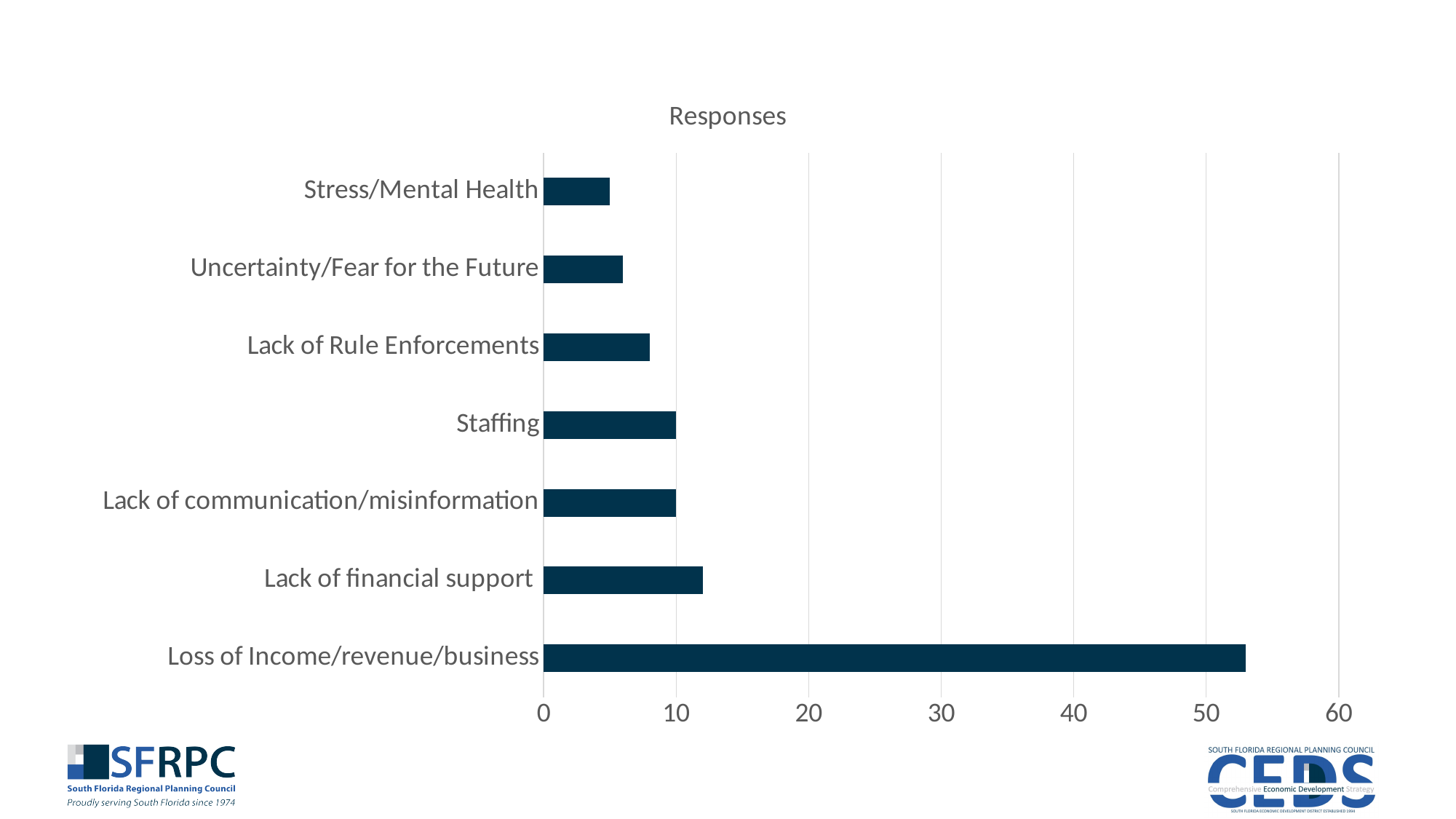
Which category has the highest number of responses? Loss of Income/revenue/business Is the value for Stress/Mental Health greater or less than 10? less Which has more responses, Loss of Income/revenue/business or Lack of financial support? Loss of Income/revenue/business How many categories are shown in the chart? 7 Is the value for Lack of financial support greater or less than 10? greater Which has more responses, Lack of Rule Enforcements or Stress/Mental Health? Lack of Rule Enforcements Is the value for Uncertainty/Fear for the Future greater or less than 10? less What is the title of the chart? Responses What kind of chart is shown on the slide? bar chart What is the value for Staffing? 10